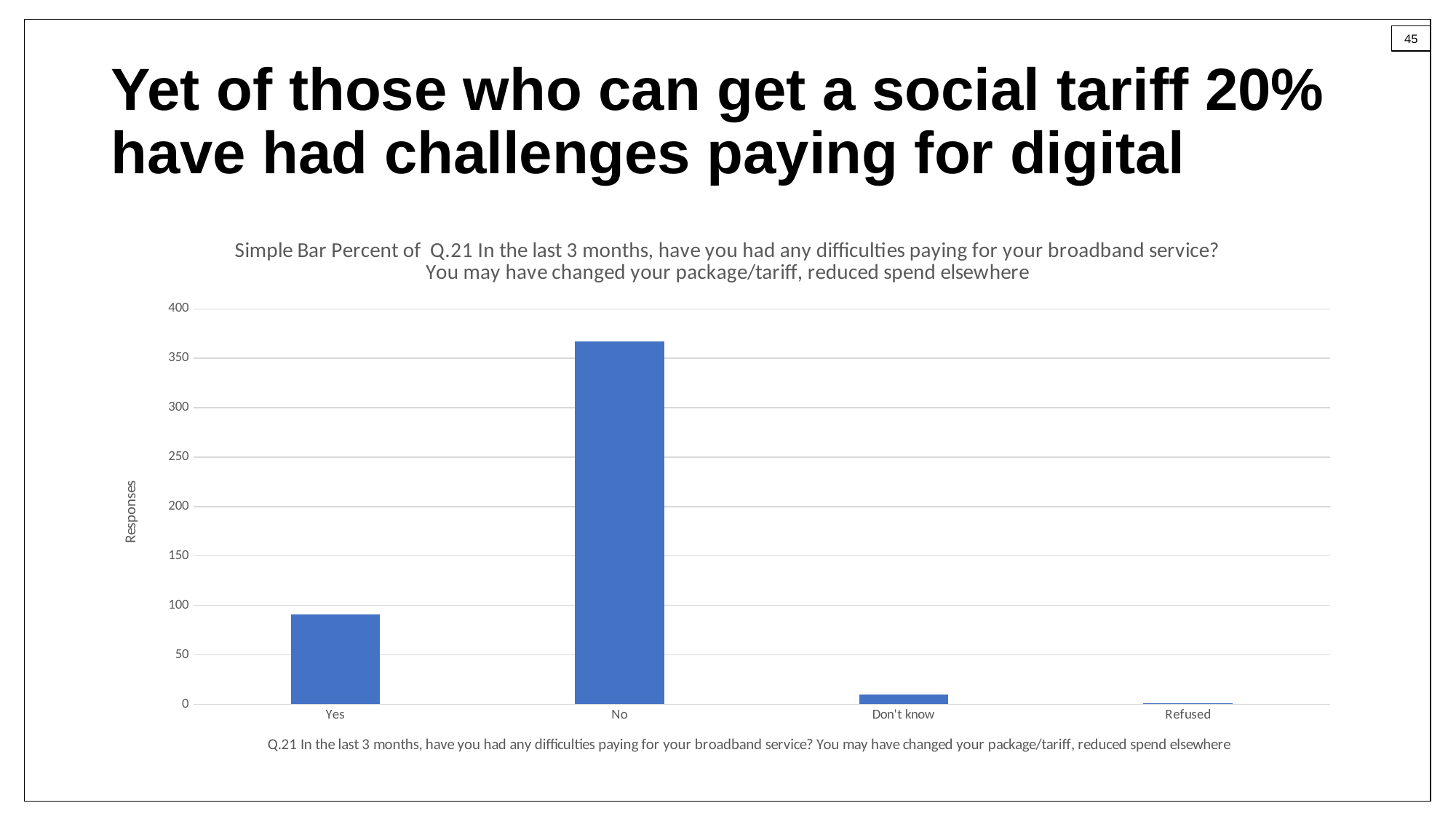
How many categories are shown on the x axis of the chart? 4 Which has more responses, Yes or Don't know? Yes Which category has the highest number of responses? No Is the value for No greater or less than 350? greater What kind of chart is shown on the slide? bar chart Is the value for Yes greater or less than 100? less Is the value for Don't know greater or less than 50? less Which has more responses, No or Yes? No What is the label on the vertical axis of the chart? Responses Which category has the lowest number of responses? Refused What is the highest value shown on the vertical axis of the chart? 400